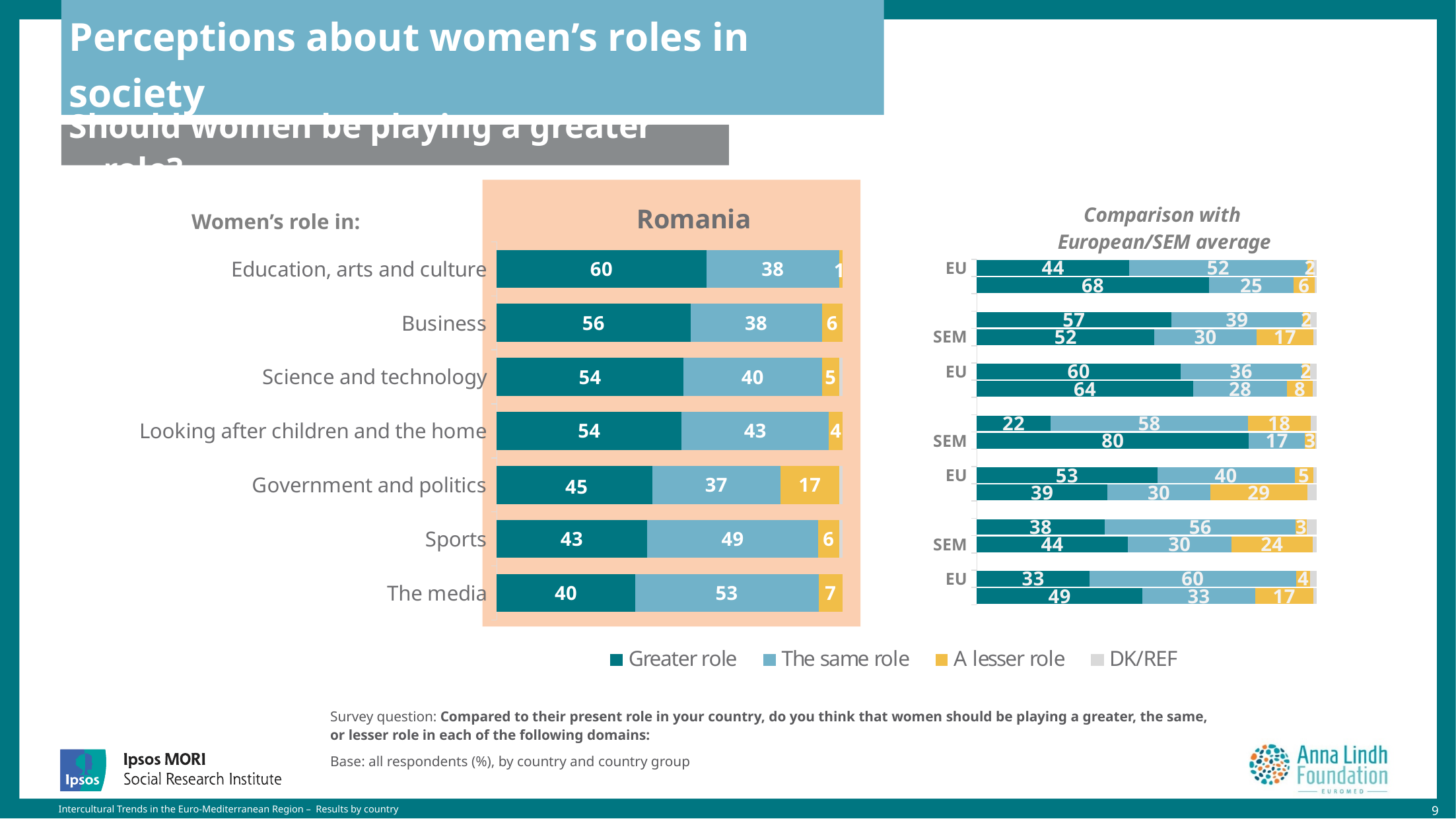
How many series does the legend list? 4 In the Romania chart, what is the 'A lesser role' value for Government and politics? 17 In the Romania chart, what percentage say women should play a greater role in Education, arts and culture? 60 In the Romania chart, what is the difference between the 'Greater role' values for Business and Sports? 13 In the Romania chart, which domain has the lowest 'Greater role' value? The media In the Romania chart, is the 'Greater role' value larger for Science and technology or for Government and politics? Science and technology In the Romania chart, what is the total of the 'Greater role' and 'The same role' values for Sports? 92 What kind of chart is the Romania chart? Stacked bar chart In the Romania chart, which domain has the highest 'A lesser role' value? Government and politics How many domains are listed in the Romania chart? 7 In the Romania chart, what is the 'The same role' value for The media? 53 In the Romania chart, which domain has the highest 'Greater role' value? Education, arts and culture